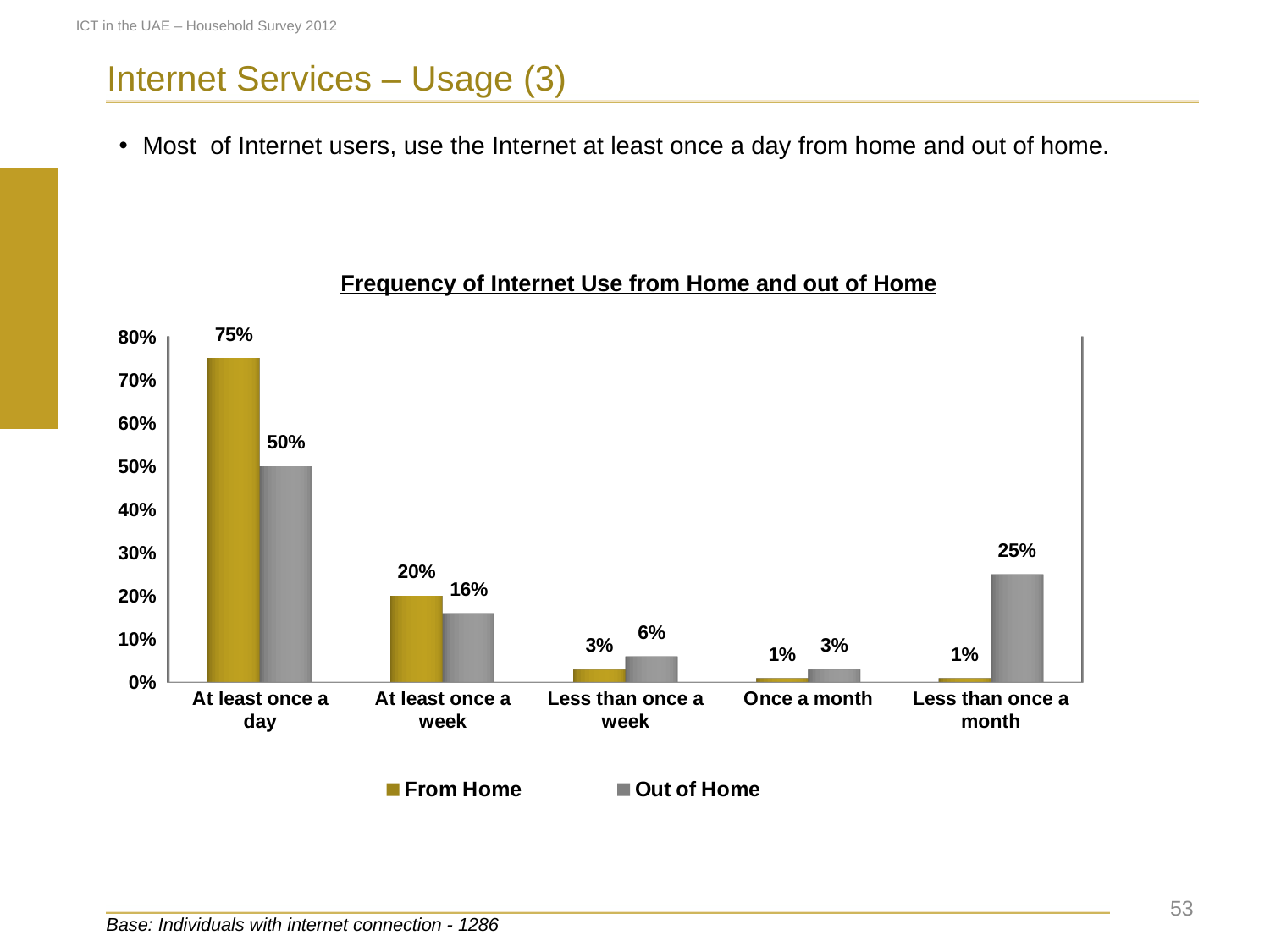
What is the From Home value for 'At least once a day'? 75% What is the difference between the From Home and Out of Home values for 'At least once a day'? 25% What is the title of the chart? Frequency of Internet Use from Home and out of Home Which category has the lowest From Home value? Once a month and Less than once a month (both 1%) Which category has the highest Out of Home value? At least once a day What is the Out of Home value for 'Less than once a month'? 25% What kind of chart is shown on the slide? Bar chart How many categories are shown on the x axis? 5 How many series does the legend list? 2 Is the Out of Home value for 'At least once a day' greater or less than 40%? greater Which is larger for 'Less than once a week': From Home or Out of Home? Out of Home What is the Out of Home value for 'At least once a week'? 16%